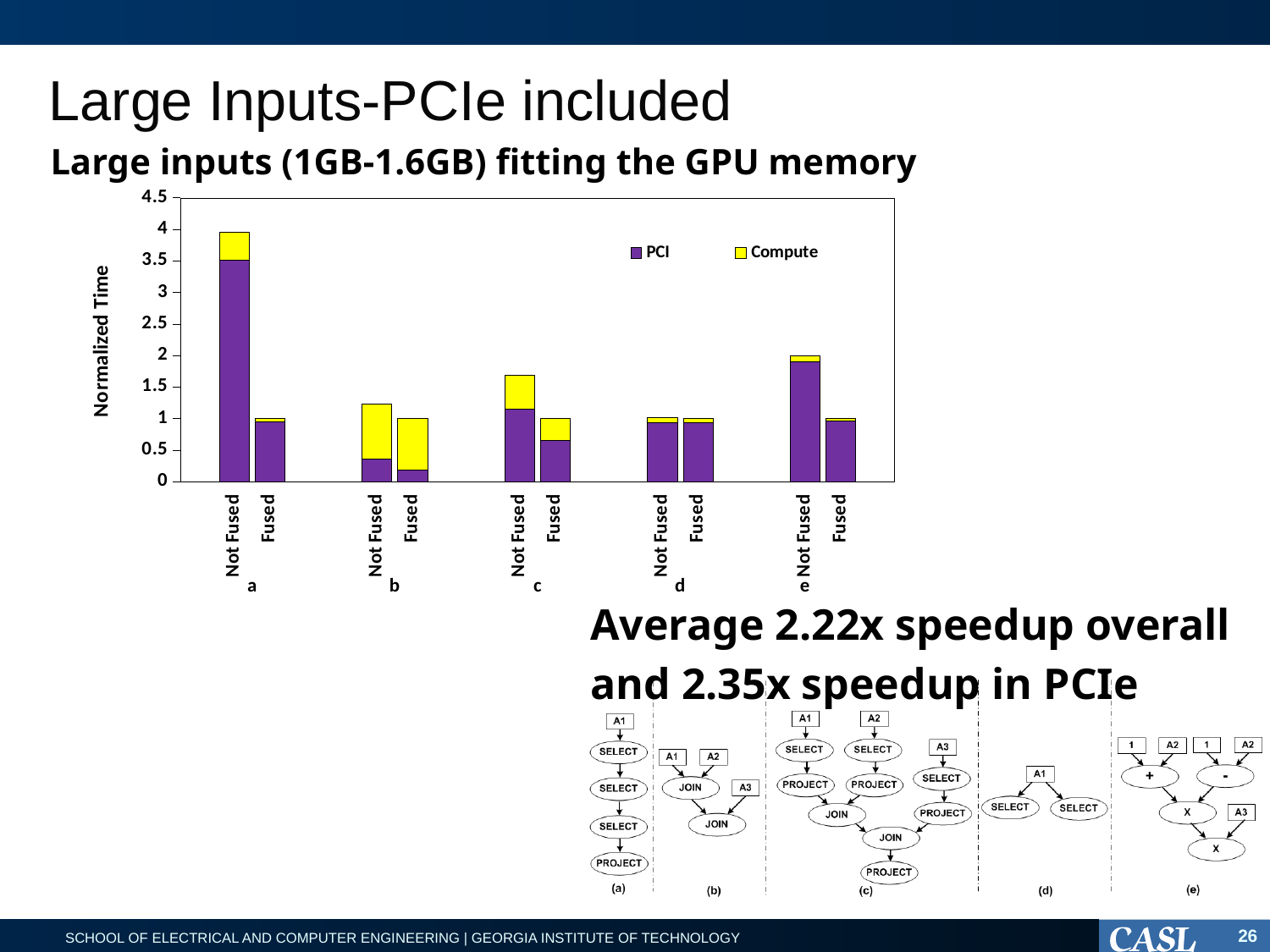
Is the total value for the Not Fused bar in group e greater or less than 1.5? greater Is the total value for the Not Fused bar in group c greater or less than 1.5? greater Is the total value for the Fused bar in group b greater or less than 1.5? less How many bars are plotted in the chart? 10 Which Not Fused bar is taller, the one in group b or the one in group c? group c How many series does the chart legend list? 2 What are the two series named in the chart legend? PCI and Compute Which is larger in group a, the Not Fused bar or the Fused bar? Not Fused What is the label of the y axis of the chart? Normalized Time Which bar has the highest total normalized time? Not Fused (a) What kind of chart is shown on the slide? stacked bar chart